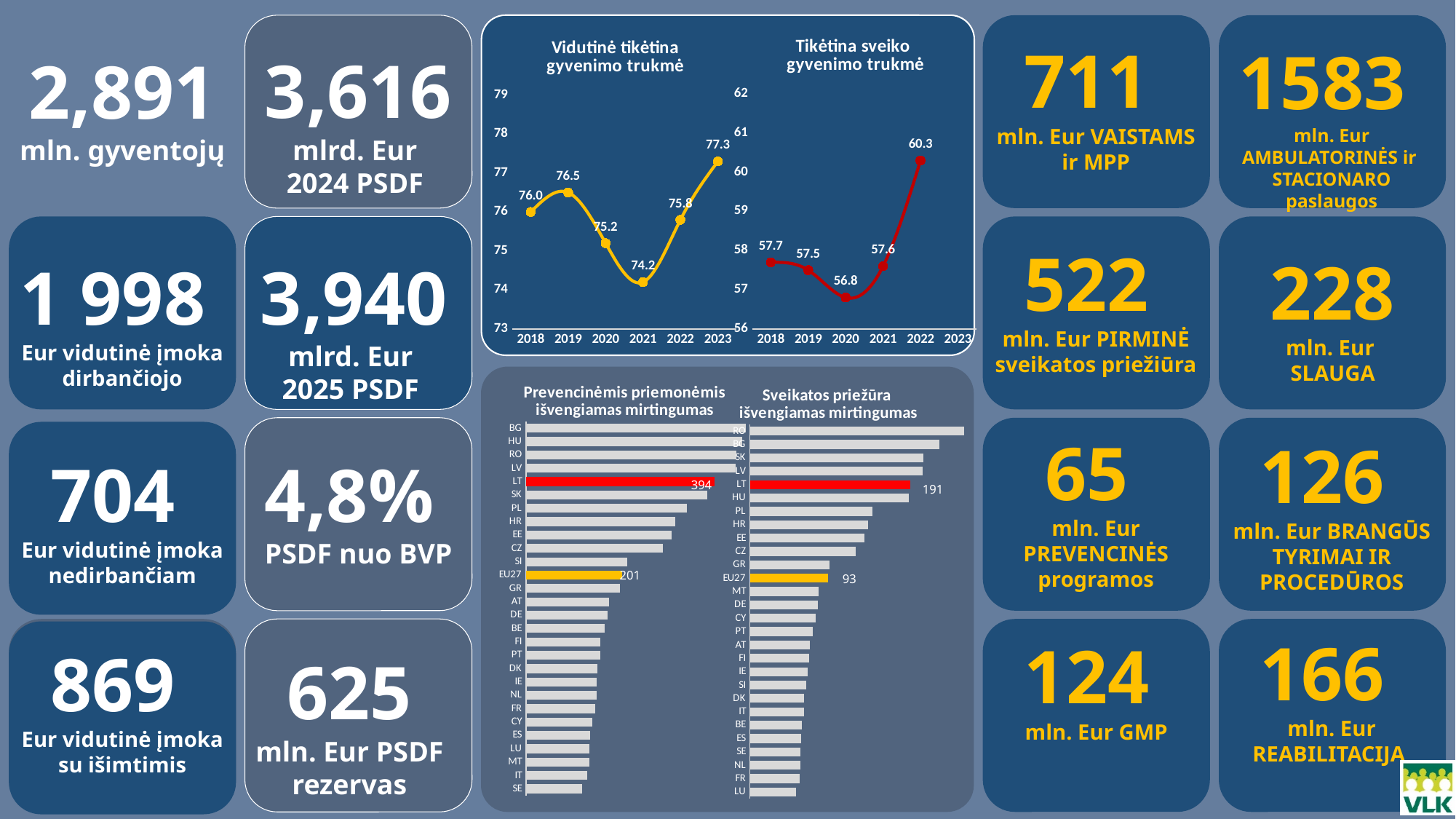
In the 'Tikėtina sveiko gyvenimo trukmė' chart, which year has the lowest value? 2020 In the 'Vidutinė tikėtina gyvenimo trukmė' chart, which year has the lowest value? 2021 In the 'Tikėtina sveiko gyvenimo trukmė' chart, what is the value for 2022? 60.3 In the 'Prevencinėmis priemonėmis išvengiamas mirtingumas' chart, what is the value for LT? 394 In the 'Vidutinė tikėtina gyvenimo trukmė' chart, what is the difference between the 2023 value and the 2021 value? 3.1 In the 'Vidutinė tikėtina gyvenimo trukmė' chart, how many data points are plotted? 6 What type of chart is the 'Sveikatos priežiūra išvengiamas mirtingumas' chart? bar chart In the 'Prevencinėmis priemonėmis išvengiamas mirtingumas' chart, what is the difference between the LT value and the EU27 value? 193 In the 'Tikėtina sveiko gyvenimo trukmė' chart, is the value for 2019 larger or smaller than the value for 2021? smaller In the 'Vidutinė tikėtina gyvenimo trukmė' chart, what is the value for 2023? 77.3 In the 'Sveikatos priežiūra išvengiamas mirtingumas' chart, what is the value for EU27? 93 In the 'Tikėtina sveiko gyvenimo trukmė' chart, what is the difference between the 2022 value and the 2018 value? 2.6